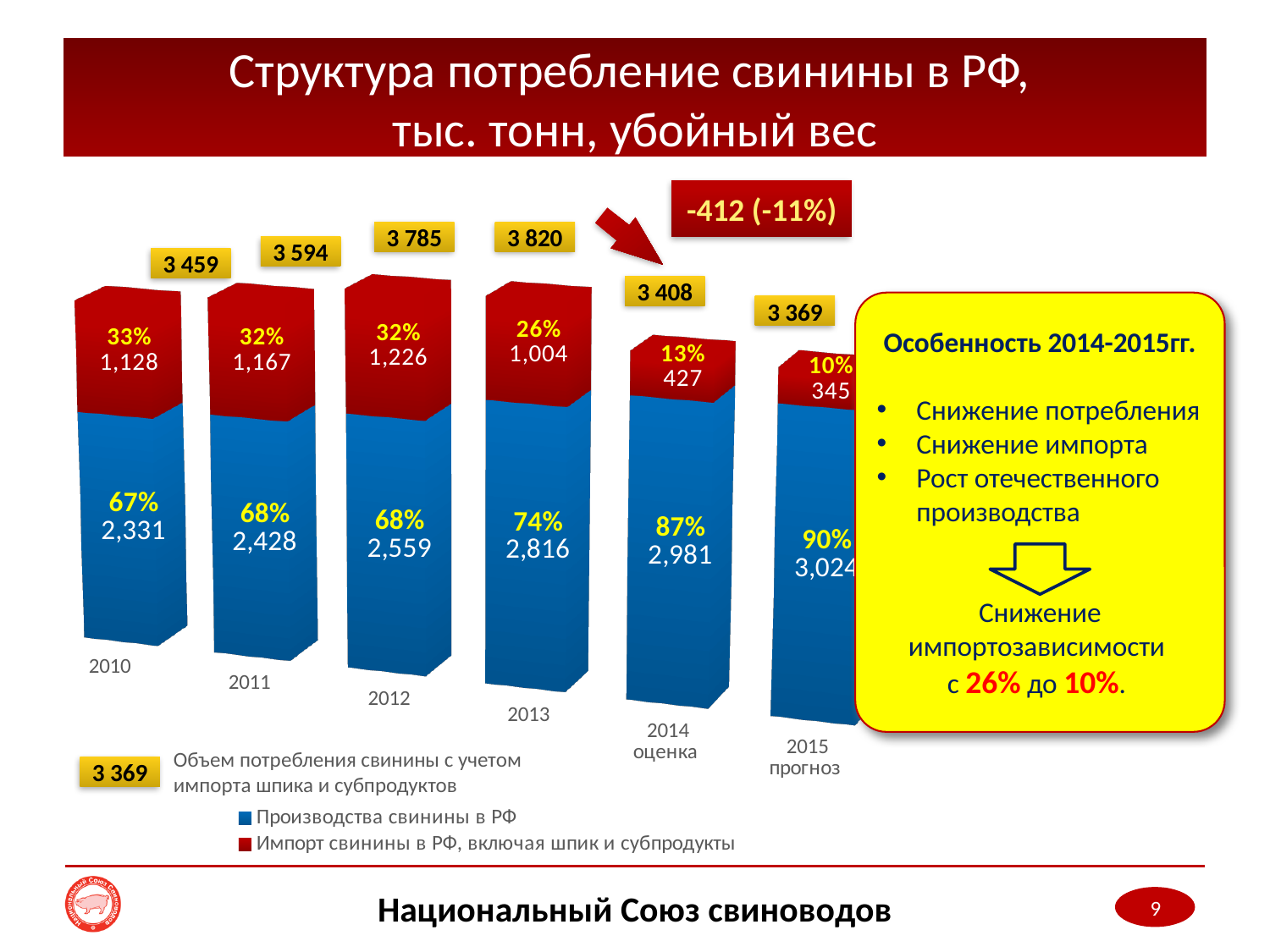
What type of chart is shown on the slide? Stacked bar chart What is the value of pork imports (Импорт свинины в РФ) in 2010? 1,128 What total consumption volume is shown in the yellow box above the 2012 bar? 3 785 Which year has the highest total pork consumption shown in the yellow boxes? 2013 Does the domestic production (blue segment) rise or fall from 2010 to 2015? Rises How many years (categories) are shown on the x axis of the chart? 6 How many series does the legend list for the stacked bars? 2 Which year has the lowest import value (red segment)? 2015 (прогноз) What share of consumption does import account for in 2014 (оценка)? 13% What is the value of domestic pork production (Производства свинины в РФ) in 2013? 2,816 Which is larger: domestic production in 2011 or domestic production in 2012? 2012 (2,559) What is the difference between the import values in 2013 and 2014? 577